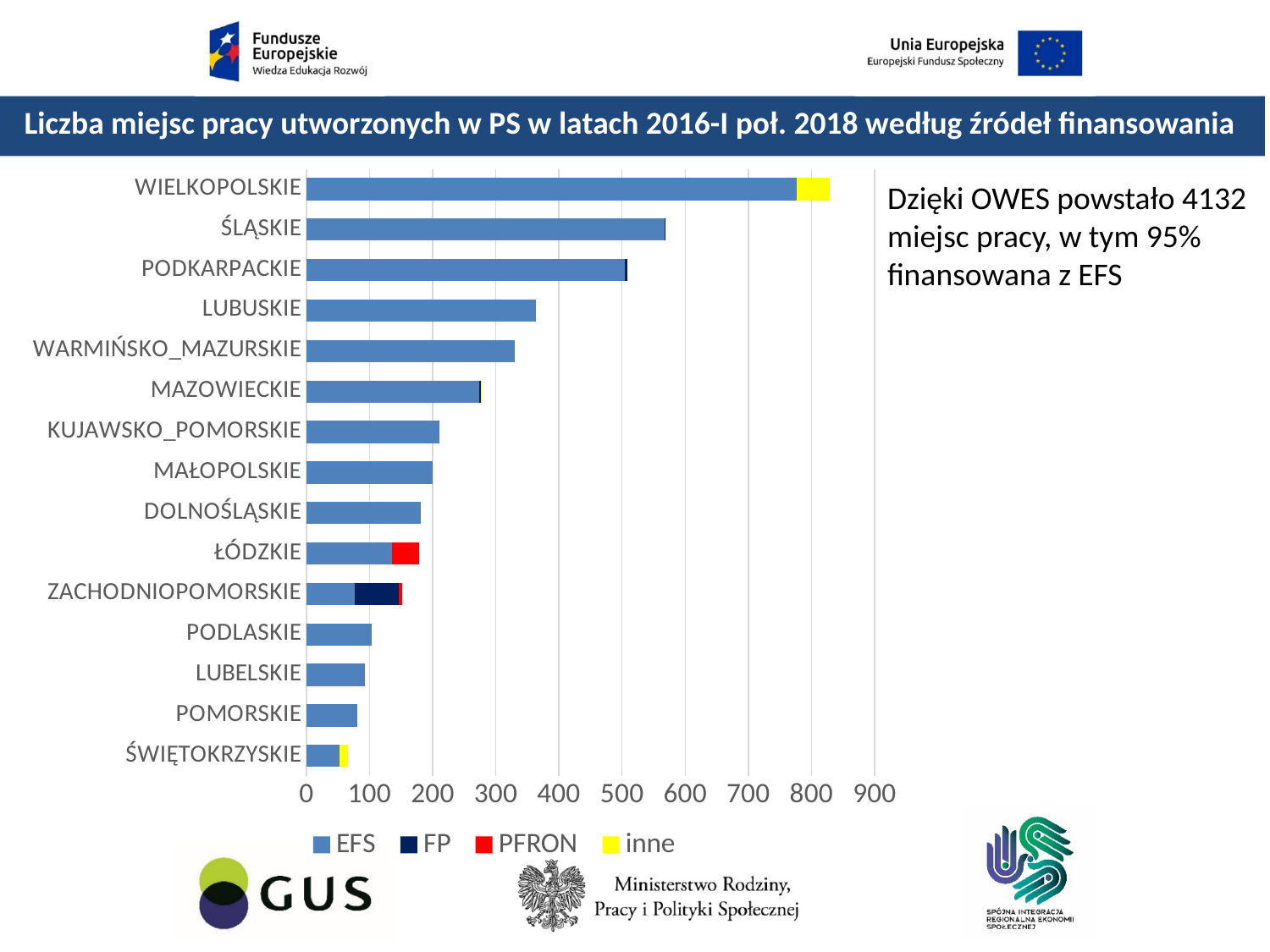
Which has a larger total, ŚLĄSKIE or PODKARPACKIE? ŚLĄSKIE Which voivodeship has the lowest total number of jobs created? ŚWIĘTOKRZYSKIE Is the total value for POMORSKIE greater or less than 100? less Is the total value for WIELKOPOLSKIE greater or less than 800? greater Is the total value for MAZOWIECKIE greater or less than 300? less How many voivodeships (categories) are listed on the chart? 15 Which voivodeship has the highest total number of jobs created? WIELKOPOLSKIE What kind of chart is shown on the slide? bar chart Which has a larger total, LUBUSKIE or WARMIŃSKO_MAZURSKIE? LUBUSKIE How many series does the chart legend list? 4 Which series in the legend is shown in yellow? inne